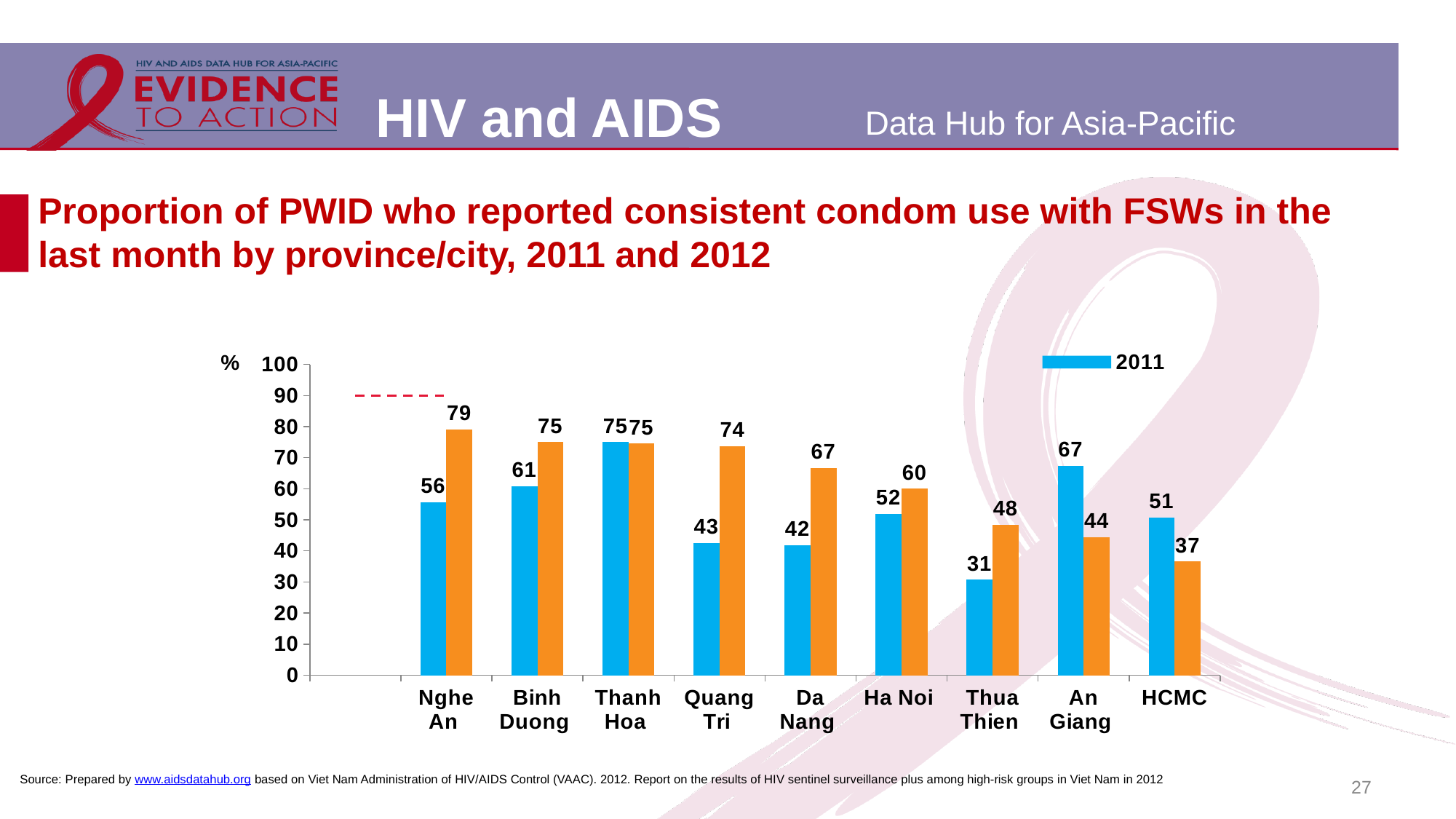
For An Giang, which year had the larger value, 2011 or 2012? 2011 What was the 2012 value for Quang Tri? 74 How many provinces/cities are shown on the x axis? 9 What value is shown for Thanh Hoa in both 2011 and 2012? 75 Which province/city had the highest 2011 value? Thanh Hoa Is the 2011 value for Da Nang greater or less than 50? less By how many percentage points did the value for Nghe An increase from 2011 to 2012? 23 What type of chart is used on this slide? bar chart What is the difference between the 2011 and 2012 values for HCMC? 14 Which province/city had the highest 2012 value? Nghe An Which province/city had the lowest 2011 value? Thua Thien What was the proportion of PWID reporting consistent condom use with FSWs in Nghe An in 2011? 56